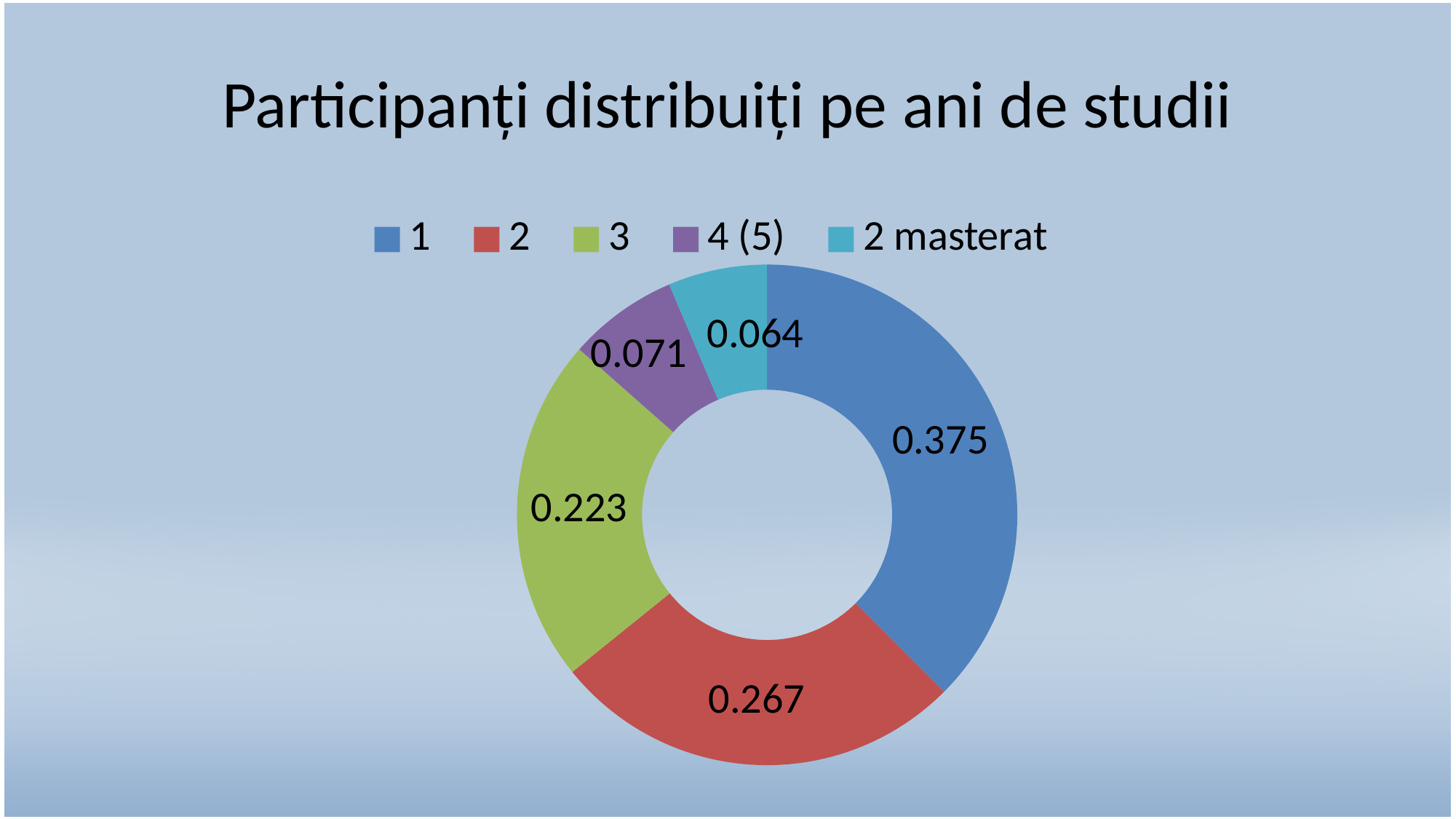
What is the value shown for category 3? 0.223 What is the difference between the values for category 1 and category 2? 0.108 What is the value shown for category 1? 0.375 How many categories does the chart show? 5 Which is larger, the value for category 3 or the value for category 4 (5)? 3 What is the title of the chart? Participanți distribuiți pe ani de studii Which category has the largest share of the chart? 1 What is the value shown for category 4 (5)? 0.071 What kind of chart is shown on the slide? Doughnut chart What is the value shown for the '2 masterat' category? 0.064 What is the value shown for category 2? 0.267 Which category has the smallest share of the chart? 2 masterat